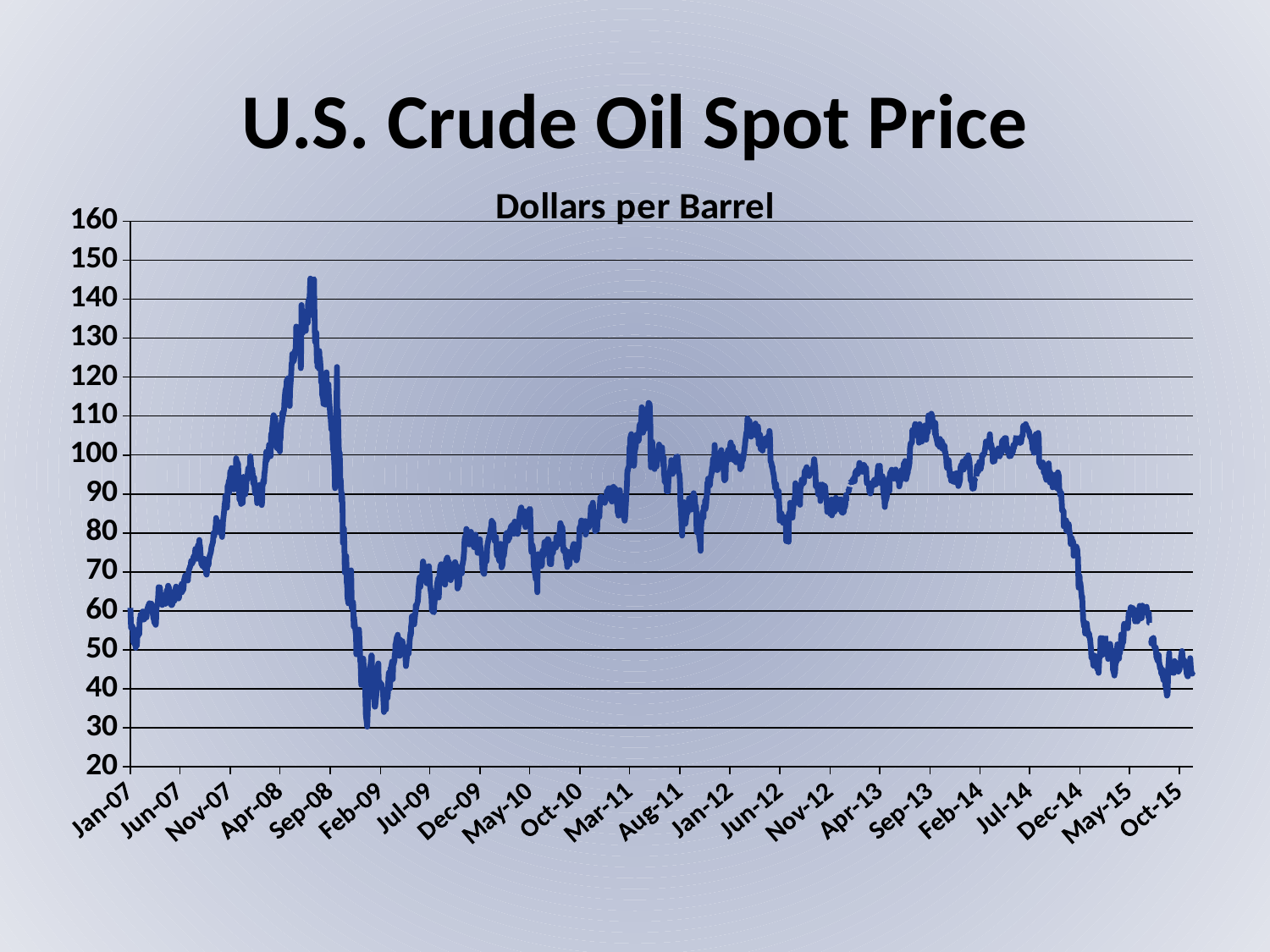
What is the title of the chart? U.S. Crude Oil Spot Price Around which period does the crude oil spot price reach its lowest point? late 2008 (around Dec-08) Does the crude oil spot price rise or fall between Jul-14 and Dec-14? fall Around which period does the crude oil spot price reach its highest point? mid-2008 (between Apr-08 and Sep-08) What unit is the price measured in, according to the chart subtitle? Dollars per Barrel Is the crude oil spot price at Jan-07 greater or less than 70? less Is the crude oil spot price at its peak in mid-2008 greater or less than 140? greater Is the crude oil spot price at Oct-15 greater or less than 60? less Does the crude oil spot price rise or fall between Jan-07 and Apr-08? rise What kind of chart is shown on the slide? line chart